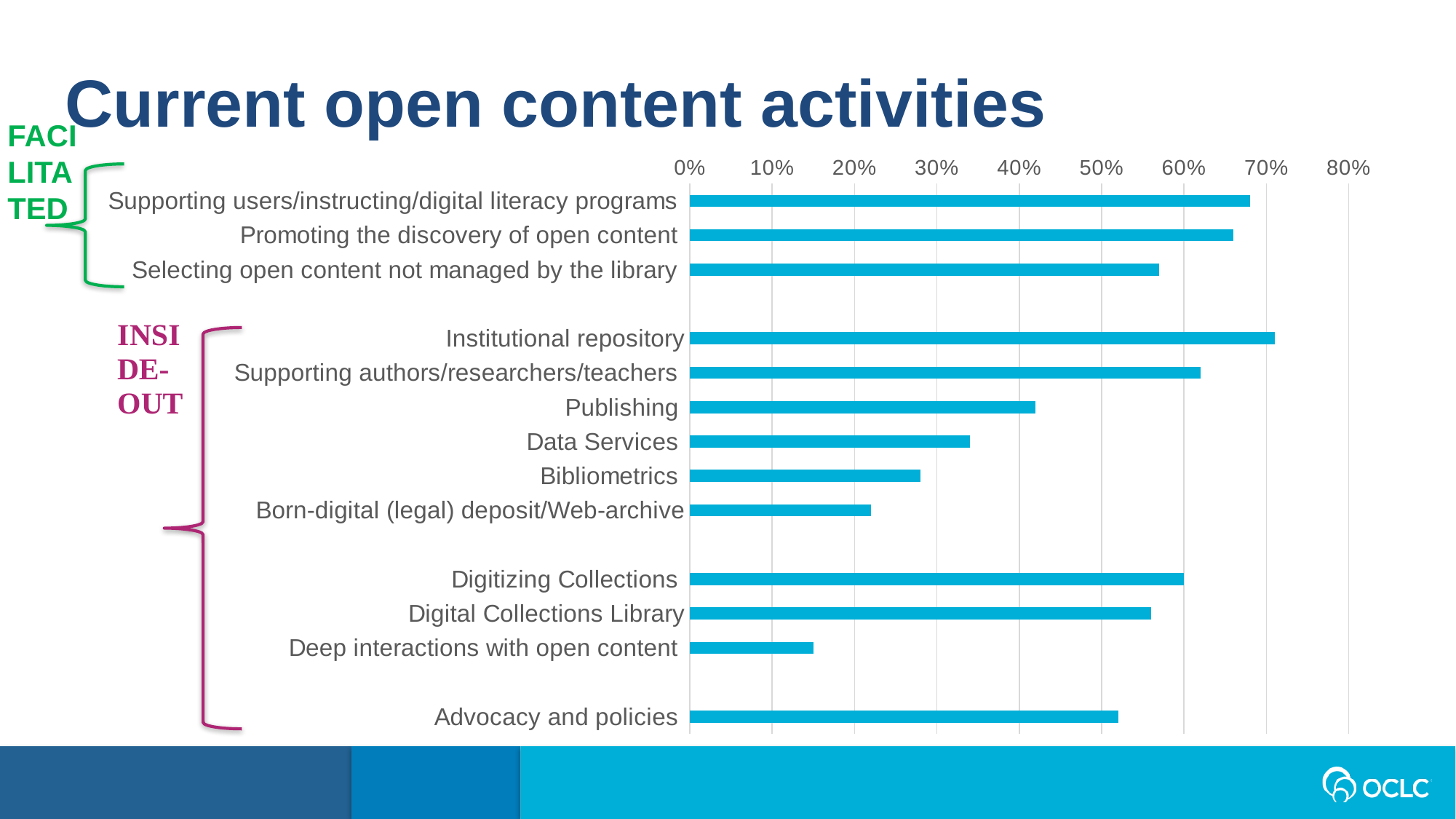
What is the title of the chart on the slide? Current open content activities Which activity has the highest value in the chart? Institutional repository Which has a larger value, Bibliometrics or Born-digital (legal) deposit/Web-archive? Bibliometrics How many activity categories are plotted in the chart? 13 Which activity has the lowest value in the chart? Deep interactions with open content Is the value for Supporting authors/researchers/teachers greater or less than 60%? greater What kind of chart is shown on the slide? bar chart Is the value for Deep interactions with open content greater or less than 20%? less Is the value for Selecting open content not managed by the library greater or less than 60%? less Which has a larger value, Digitizing Collections or Advocacy and policies? Digitizing Collections Which has a larger value, Publishing or Data Services? Publishing